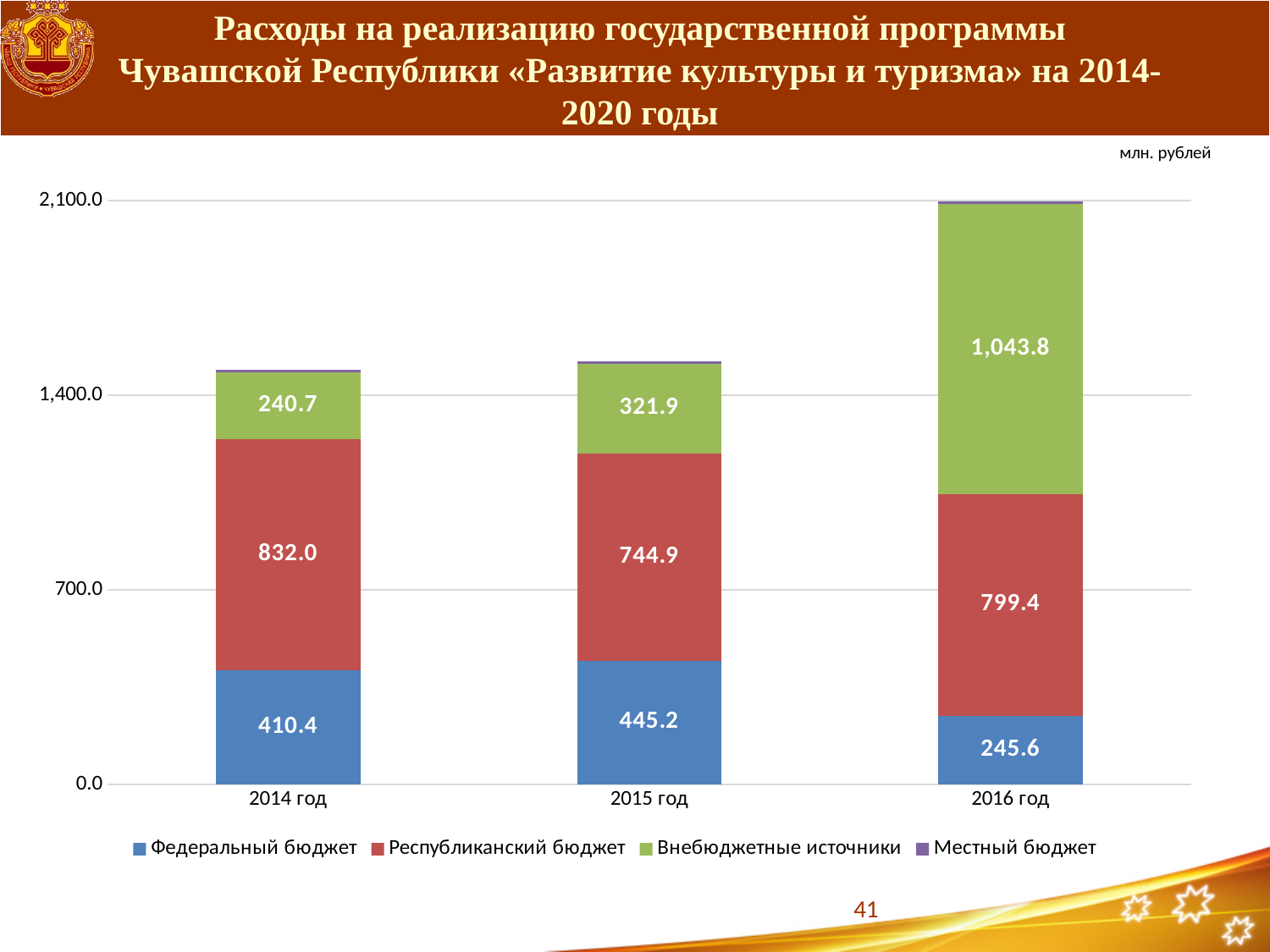
Which is larger: Республиканский бюджет in 2014 год or in 2016 год? 2014 год What is the difference between Внебюджетные источники in 2016 год and in 2015 год? 721.9 How many series does the legend list? 4 What is the value of Республиканский бюджет for 2015 год? 744.9 What is the value of Федеральный бюджет for 2016 год? 245.6 Is the total height of the 2016 год bar greater or less than 1,400.0? greater In which year is Внебюджетные источники the highest? 2016 год Do the values for Внебюджетные источники rise or fall from 2014 год to 2016 год? rise What is the value of Внебюджетные источники for 2016 год? 1,043.8 What is the difference between Федеральный бюджет in 2015 год and in 2016 год? 199.6 What is the value of Федеральный бюджет for 2014 год? 410.4 In which year is Федеральный бюджет the lowest? 2016 год